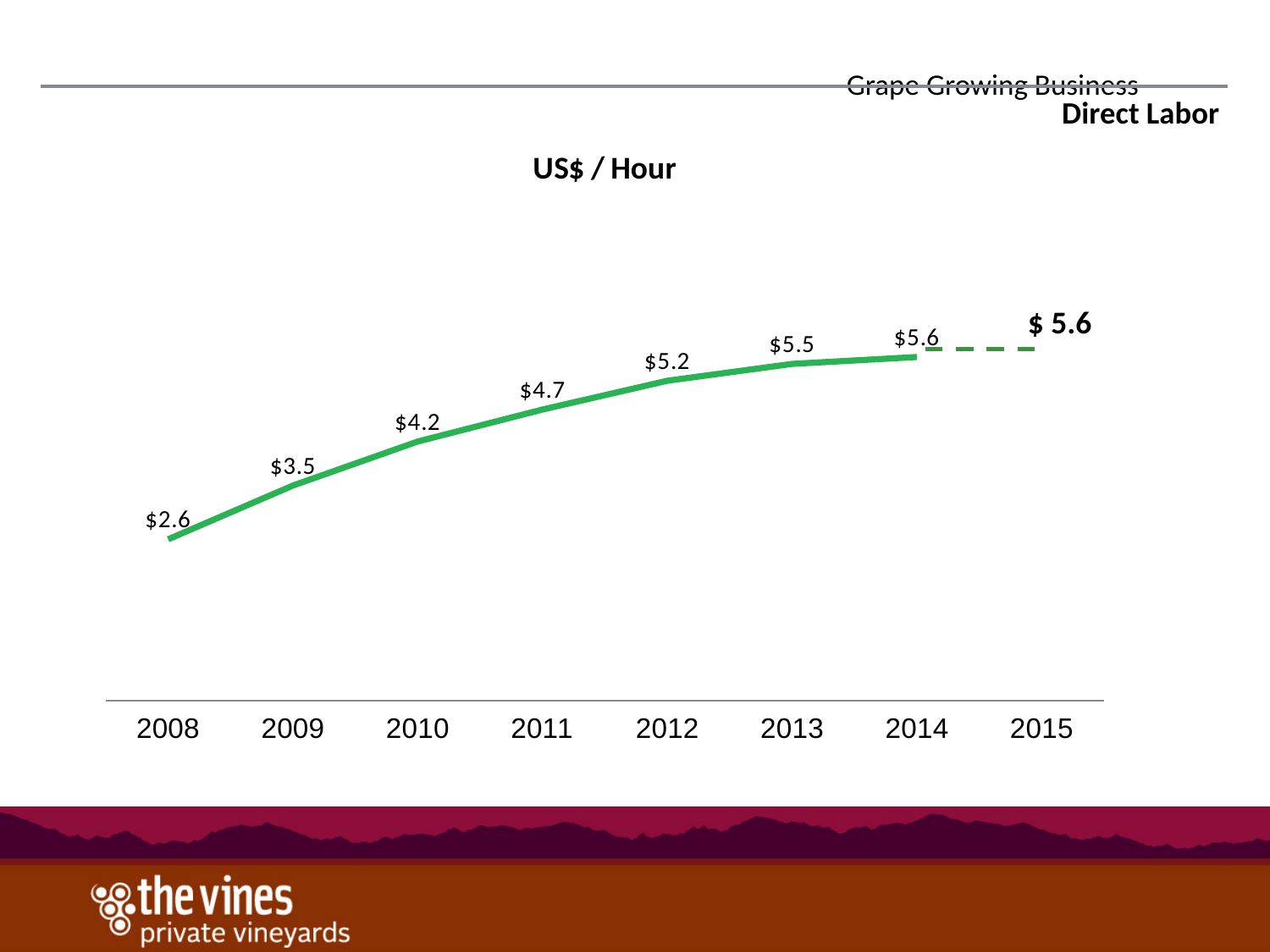
What is the value for 2008? $2.6 What is the difference between the values for 2014 and 2008? $3.0 Which is larger, the value for 2012 or the value for 2010? 2012 What is the title of the chart? US$ / Hour What is the difference between the values for 2010 and 2009? $0.7 How many years are shown on the x axis? 8 What is the value for 2011? $4.7 What is the value for 2013? $5.5 Do the values rise or fall from 2008 to 2014? rise What kind of chart is this? line chart Which year has the lowest value? 2008 What is the value shown for 2015? $ 5.6